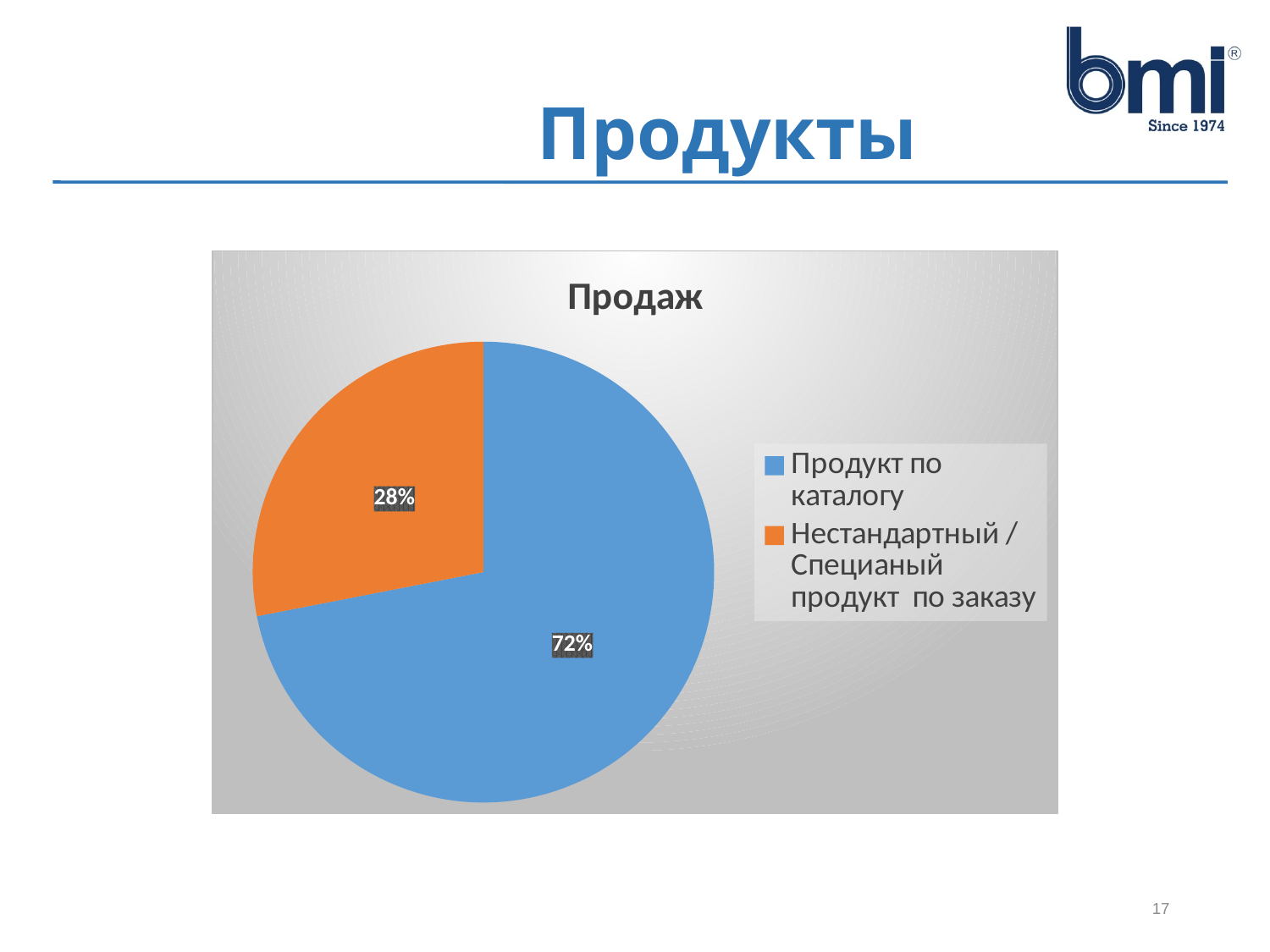
Which slice is the smallest? Нестандартный / Специаный продукт по заказу Which slice is the largest? Продукт по каталогу What is the difference in percentage points between the "Продукт по каталогу" slice and the "Нестандартный / Специаный продукт по заказу" slice? 44 How many entries does the legend list? 2 What is the title of the chart? Продаж What share of the pie does "Нестандартный / Специаный продукт по заказу" have? 28% How many slices does the pie chart have? 2 What kind of chart is shown on the slide? pie chart Which is larger: the share for "Продукт по каталогу" or the share for "Нестандартный / Специаный продукт по заказу"? Продукт по каталогу What share of the pie does "Продукт по каталогу" have? 72% What colour is the slice for "Нестандартный / Специаный продукт по заказу"? orange